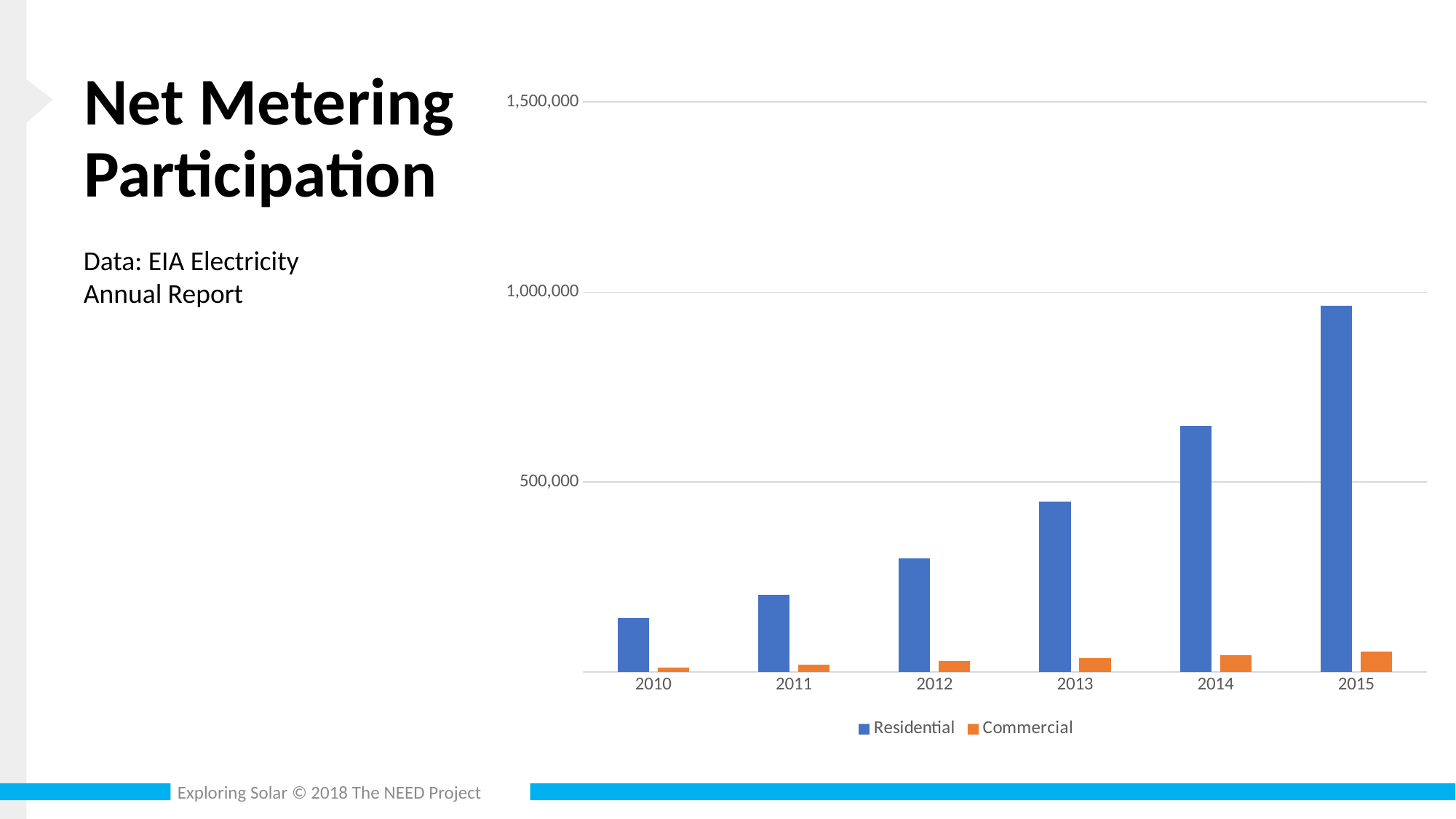
How many series does the chart's legend list? 2 Which year has the highest Residential value? 2015 Is the Residential value for 2014 greater or less than 500,000? greater Which year has the lowest Residential value? 2010 Is the Residential value for 2015 greater or less than 1,000,000? less How many years are shown on the x axis of the chart? 6 Is the Residential value for 2013 greater or less than 500,000? less What colour are the Commercial bars in the chart? orange Which is larger in 2012, the Residential value or the Commercial value? Residential What kind of chart is shown on the slide? bar chart Do the Residential values rise or fall from 2010 to 2015? rise Which year has the highest Commercial value? 2015